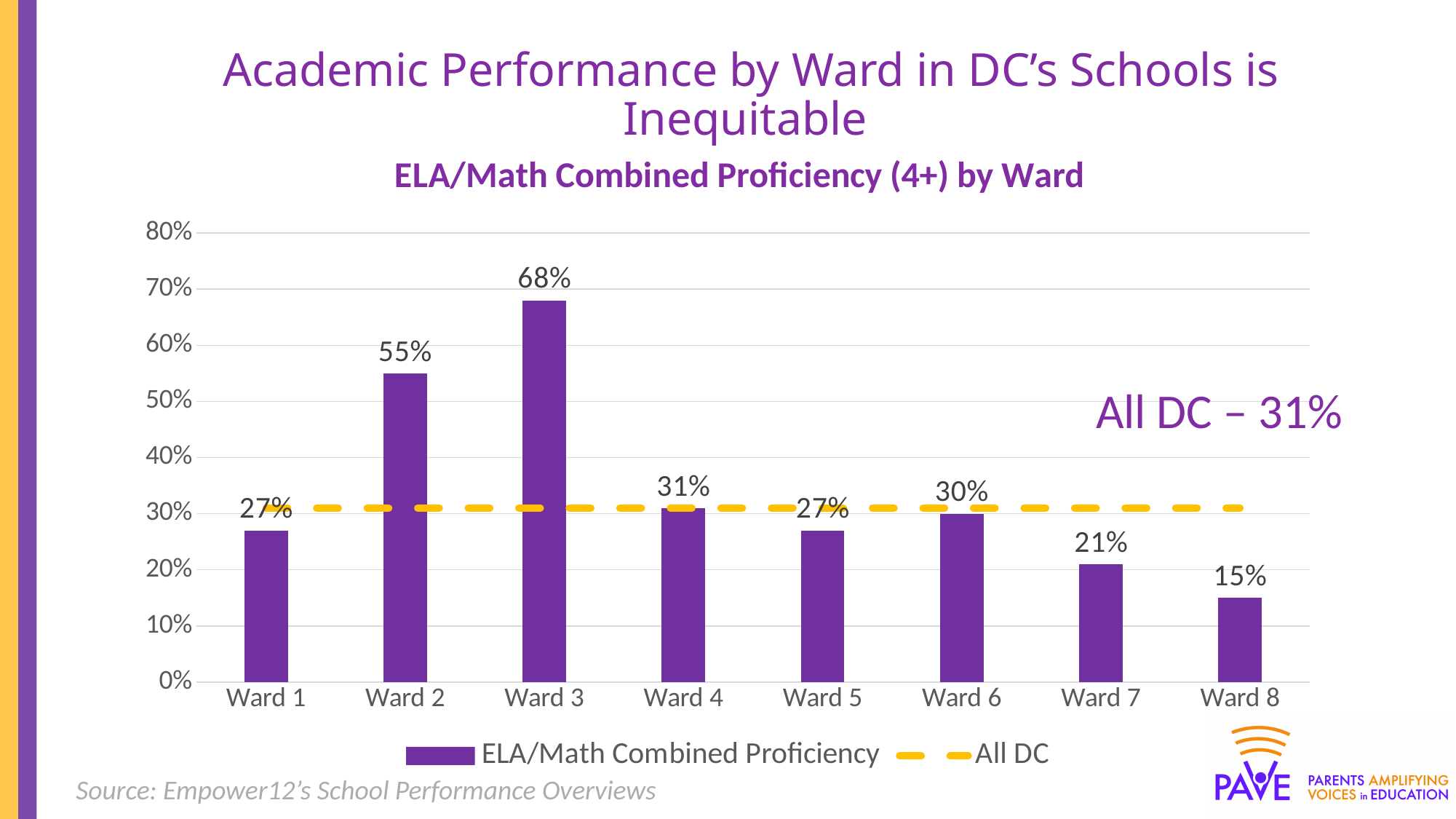
What is the difference in ELA/Math Combined Proficiency between Ward 3 and Ward 8? 53% How many wards are shown on the x axis of the chart? 8 How many series does the chart legend list? 2 Which ward has the lowest ELA/Math Combined Proficiency? Ward 8 What kind of chart is used to show ELA/Math Combined Proficiency by Ward? Bar chart Which has a higher ELA/Math Combined Proficiency, Ward 2 or Ward 4? Ward 2 What is the ELA/Math Combined Proficiency value for Ward 6? 30% What value does the dashed 'All DC' line represent? 31% What is the ELA/Math Combined Proficiency value for Ward 3? 68% What is the ELA/Math Combined Proficiency value for Ward 8? 15% Is the ELA/Math Combined Proficiency for Ward 7 greater or less than 30%? less Which ward has the highest ELA/Math Combined Proficiency? Ward 3